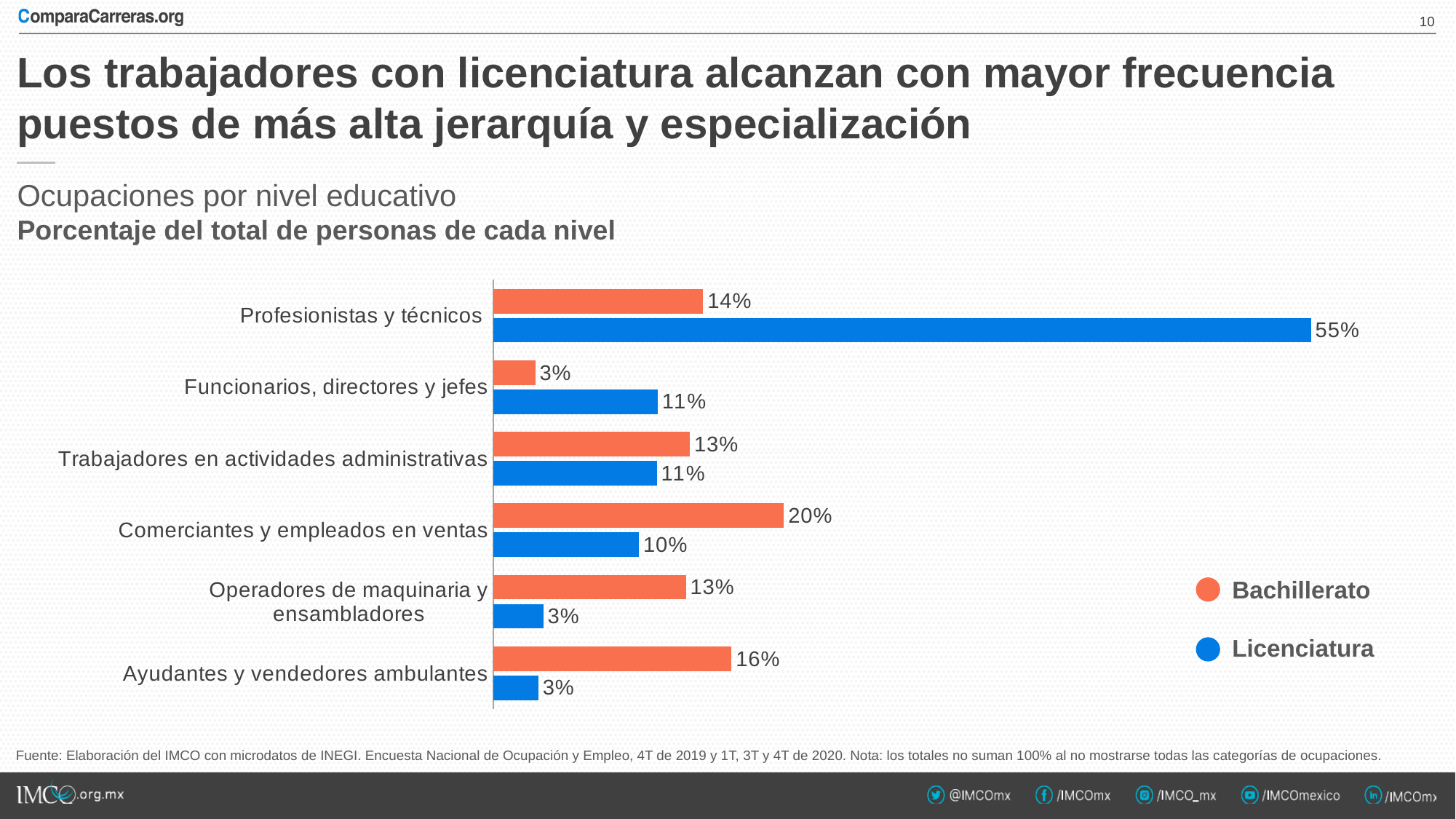
Which occupation has the lowest Bachillerato value? Funcionarios, directores y jefes What is the difference between the Licenciatura and Bachillerato values for Profesionistas y técnicos? 41% What is the Licenciatura value for Operadores de maquinaria y ensambladores? 3% Which occupation has the highest Licenciatura value? Profesionistas y técnicos How many occupation categories are shown in the chart? 6 How many series does the legend list? 2 What kind of chart is shown on the slide? Bar chart What is the difference between the Bachillerato and Licenciatura values for Comerciantes y empleados en ventas? 10% Which colour represents Licenciatura in the legend? Blue What is the Bachillerato value for Comerciantes y empleados en ventas? 20% For Ayudantes y vendedores ambulantes, which is larger: the Bachillerato value or the Licenciatura value? Bachillerato What is the Licenciatura value for Profesionistas y técnicos? 55%